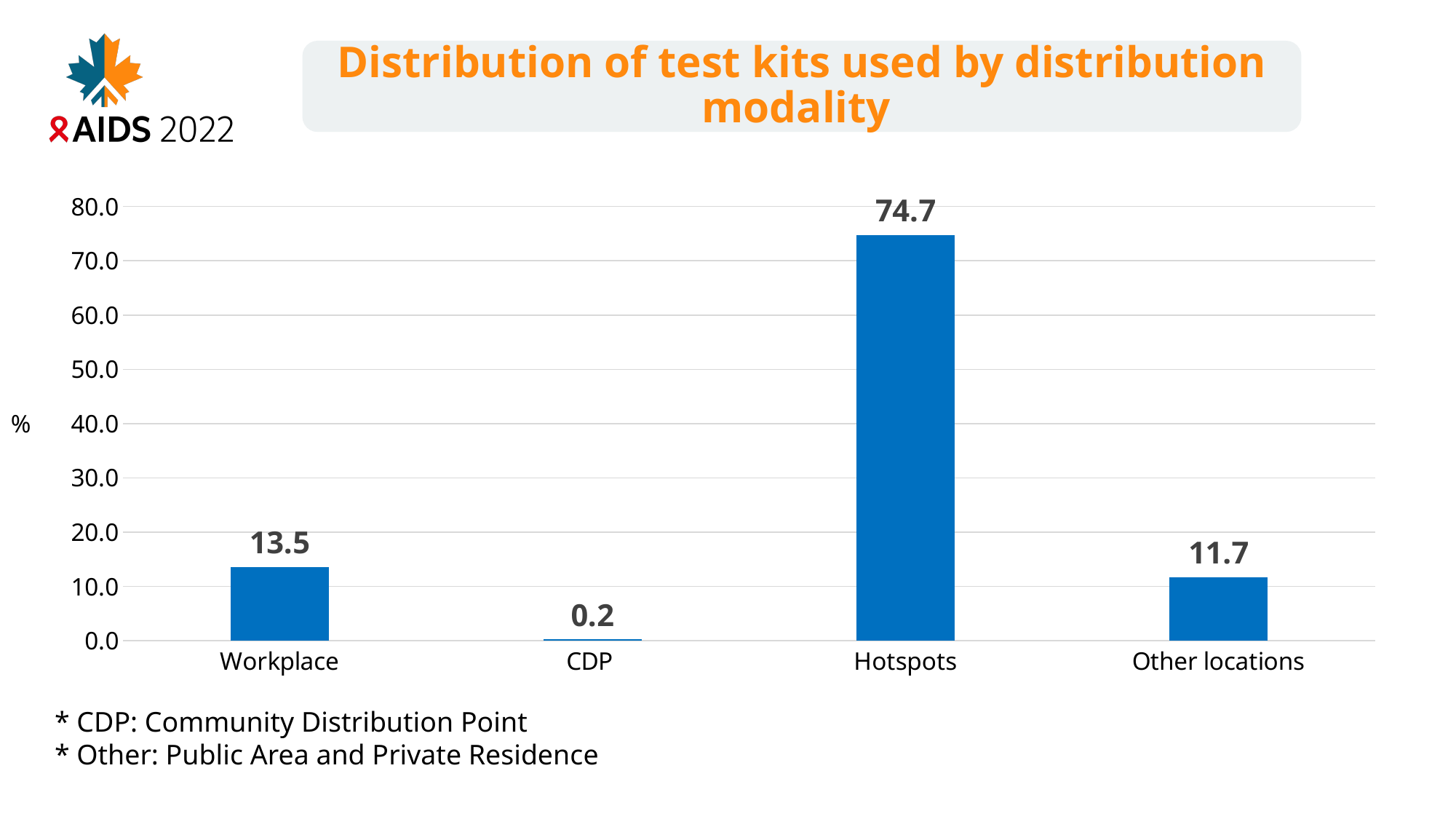
How many distribution modalities are shown on the chart? 4 What is the value for Workplace? 13.5 What is the value for Other locations? 11.7 What is the title of the chart? Distribution of test kits used by distribution modality What kind of chart is shown on the slide? Bar chart What is the value for CDP? 0.2 What is the value for Hotspots? 74.7 Which is larger, the value for Workplace or the value for Other locations? Workplace Which distribution modality has the highest value? Hotspots What is the difference between the values for Workplace and Other locations? 1.8 Which distribution modality has the lowest value? CDP What is the difference between the values for Hotspots and Workplace? 61.2